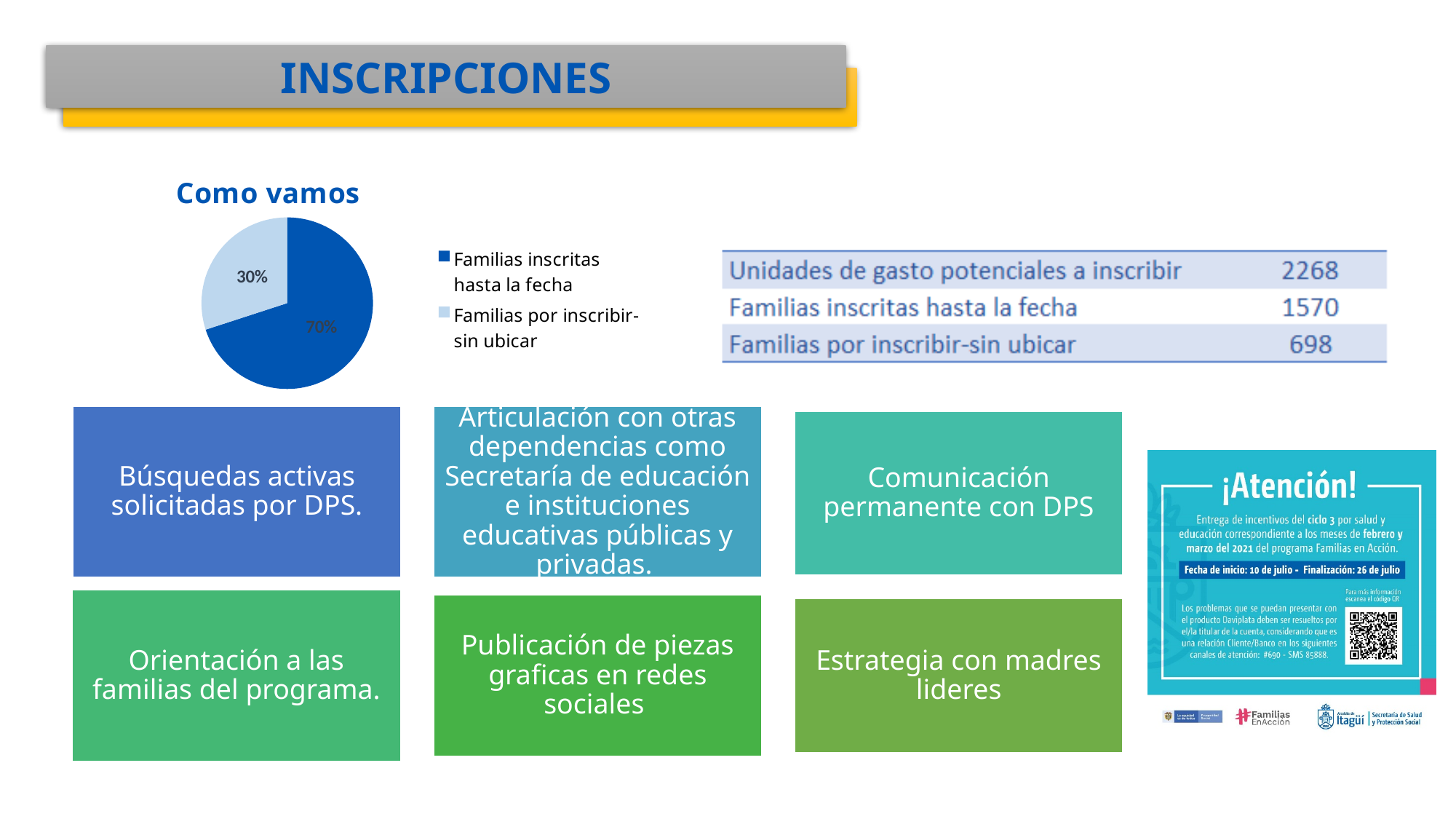
What is the difference in percentage points between the two slices of the pie chart? 40 How many entries does the pie chart's legend list? 2 What percentage of the pie chart is labelled for "Familias inscritas hasta la fecha"? 70% What is the title shown above the pie chart? Como vamos What percentage of the pie chart is labelled for "Familias por inscribir-sin ubicar"? 30% Which slice of the pie chart is the smallest? Familias por inscribir-sin ubicar How many slices does the pie chart have? 2 Which legend entry of the pie chart is shown in dark blue? Familias inscritas hasta la fecha Which slice of the pie chart is the largest? Familias inscritas hasta la fecha Which is larger in the pie chart: "Familias inscritas hasta la fecha" or "Familias por inscribir-sin ubicar"? Familias inscritas hasta la fecha What kind of chart is shown under the heading "Como vamos"? pie chart